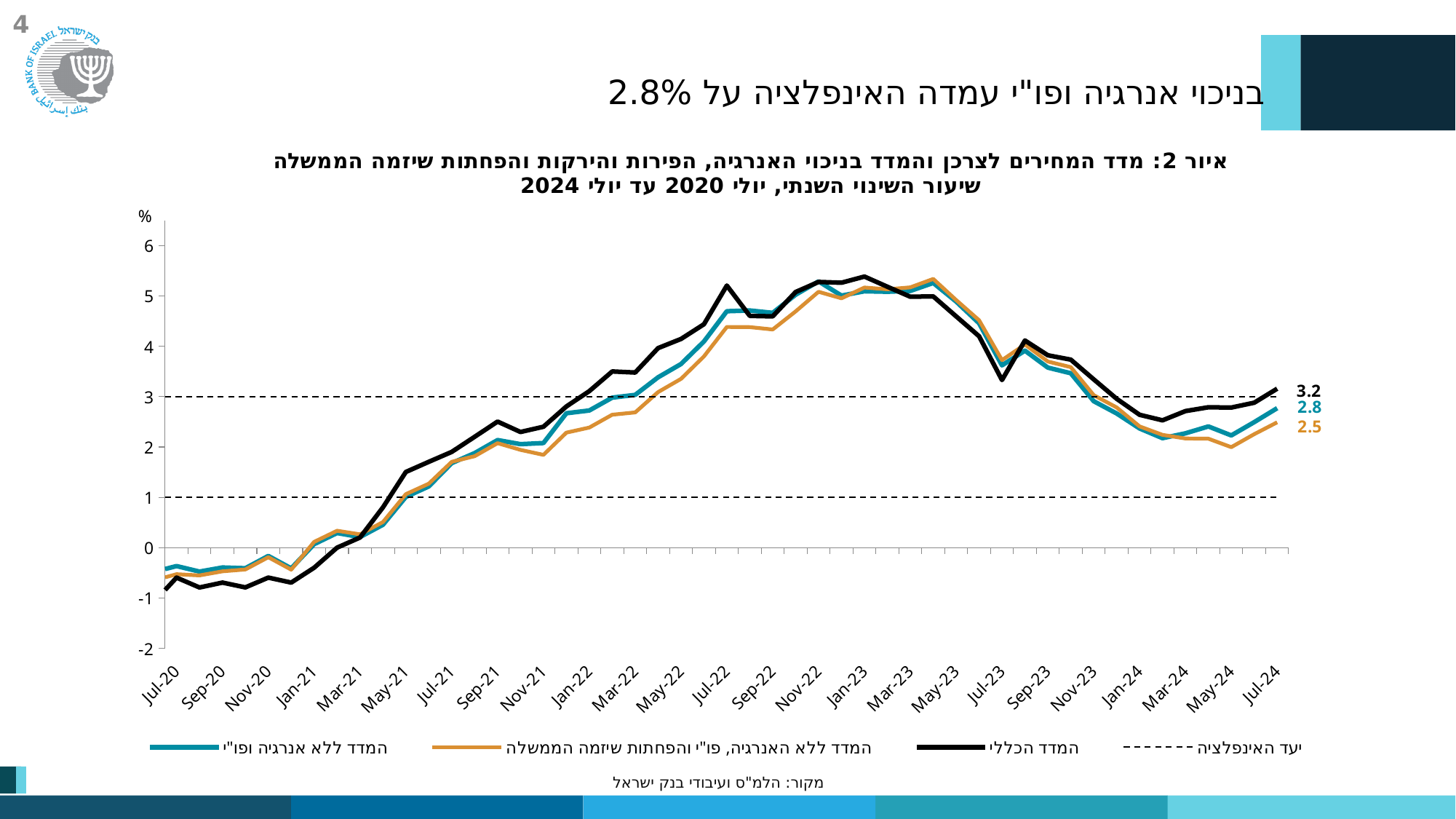
What is the difference between the Jul-24 labelled values of the black line (3.2) and the teal line (2.8)? 0.4 Which series has the lowest labelled value in Jul-24? המדד ללא האנרגיה, פו"י והפחתות שיזמה הממשלה What is the value labelled at the end of the teal line (המדד ללא אנרגיה ופו"י) in Jul-24? 2.8 What is the value labelled at the end of the black line (המדד הכללי) in Jul-24? 3.2 What is the difference between the Jul-24 labelled values of the black line (3.2) and the orange line (2.5)? 0.7 Is the value of the black line (המדד הכללי) in Sep-20 greater or less than 0? less What is the value labelled at the end of the orange line (המדד ללא האנרגיה, פו"י והפחתות שיזמה הממשלה) in Jul-24? 2.5 How many series does the legend list? 4 Is the value of the black line (המדד הכללי) in Jan-23 greater or less than 5? greater What type of chart is shown on the slide? line chart At which two levels are the dashed inflation-target lines (יעד האינפלציה) drawn? 1 and 3 Which series has the highest labelled value in Jul-24? המדד הכללי